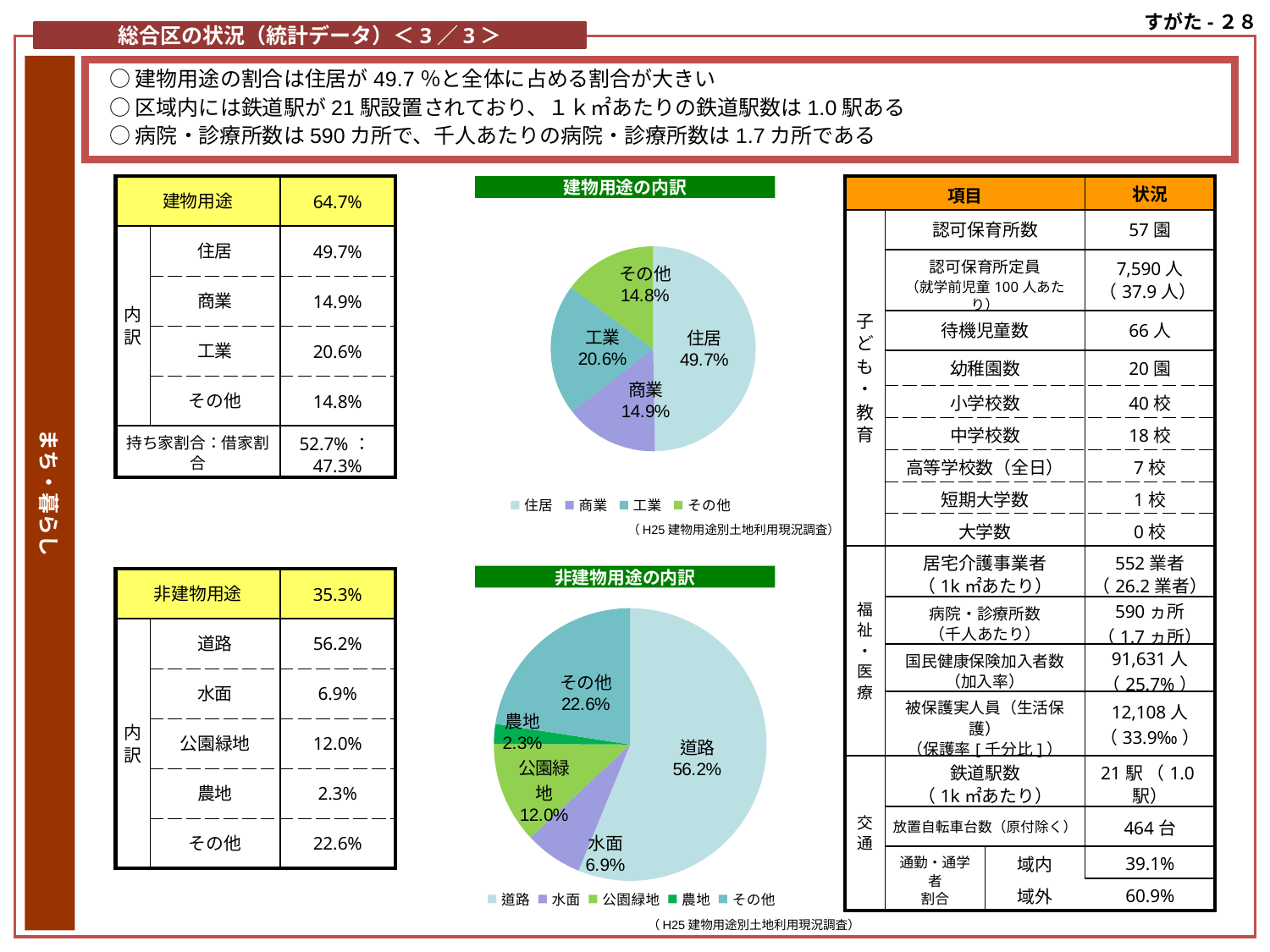
In the 建物用途の内訳 chart, what is the share for 工業? 20.6% In the 建物用途の内訳 chart, what is the share for 住居? 49.7% What kind of chart is the 建物用途の内訳 chart? pie chart In the 非建物用途の内訳 chart, what is the share for 公園緑地? 12.0% In the 非建物用途の内訳 chart, what is the share for 道路? 56.2% In the 非建物用途の内訳 chart, which category has the smallest share? 農地 In the 非建物用途の内訳 chart, how many entries does the legend list? 5 In the 非建物用途の内訳 chart, what is the difference between the shares of 道路 and 水面? 49.3% In the 非建物用途の内訳 chart, which is larger, 水面 or その他? その他 In the 建物用途の内訳 chart, what is the difference between the shares of 工業 and 商業? 5.7% In the 建物用途の内訳 chart, how many categories are shown? 4 In the 建物用途の内訳 chart, which category has the largest share? 住居